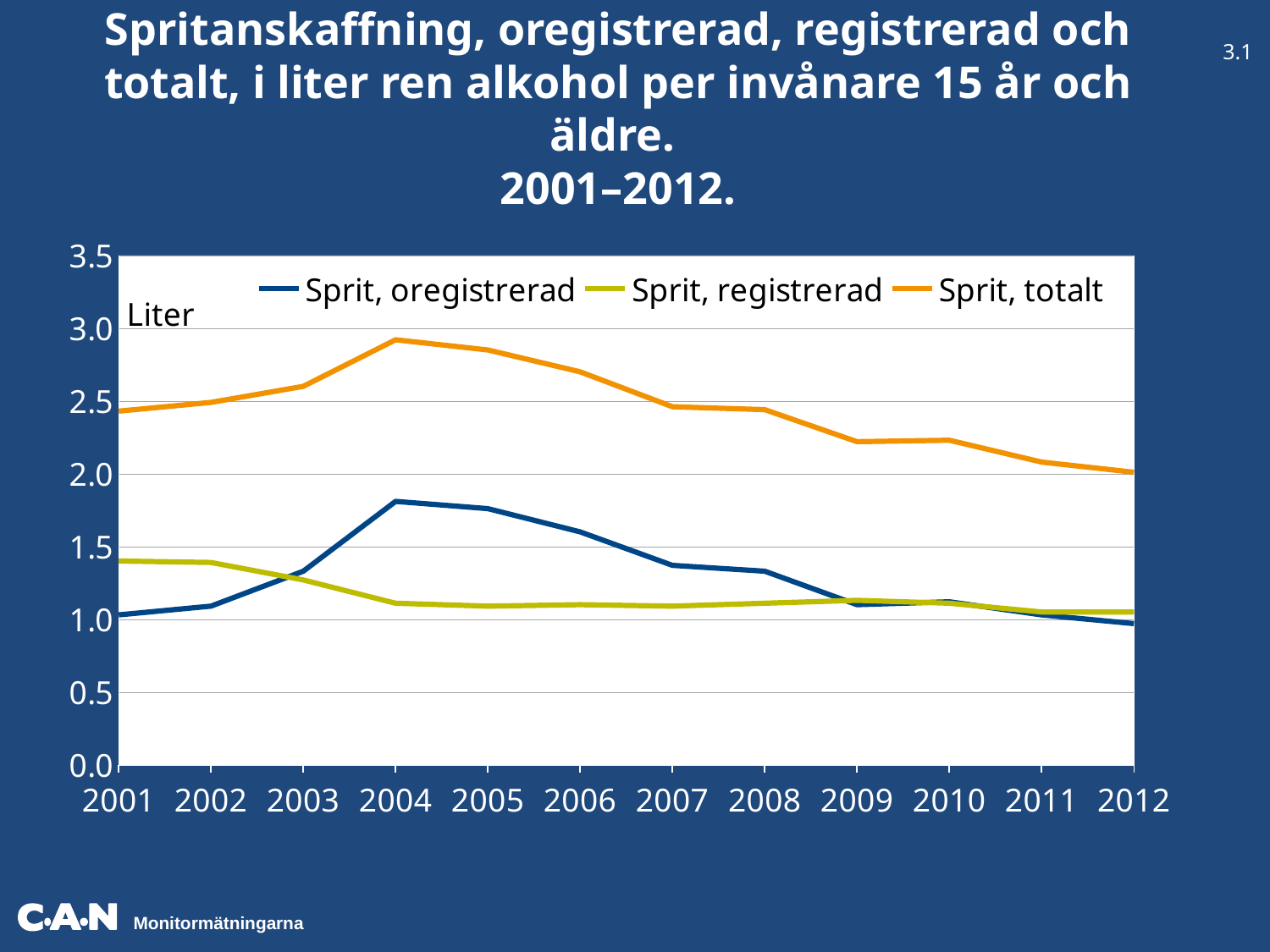
In 2001, which is larger: Sprit, registrerad or Sprit, oregistrerad? Sprit, registrerad Is the value for Sprit, totalt in 2012 greater or less than 2.5? less Does the Sprit, totalt series rise or fall from 2004 to 2012? Fall Is the value for Sprit, totalt in 2004 greater or less than 2.5? greater How many years are plotted along the x axis? 12 In 2004, which is larger: Sprit, oregistrerad or Sprit, registrerad? Sprit, oregistrerad In which year is the Sprit, totalt series at its lowest value? 2012 Is the value for Sprit, oregistrerad in 2004 greater or less than 1.5? greater In which year does the Sprit, oregistrerad series reach its highest value? 2004 In which year does the Sprit, totalt series reach its highest value? 2004 What kind of chart is shown on the slide? Line chart How many series does the legend list? 3